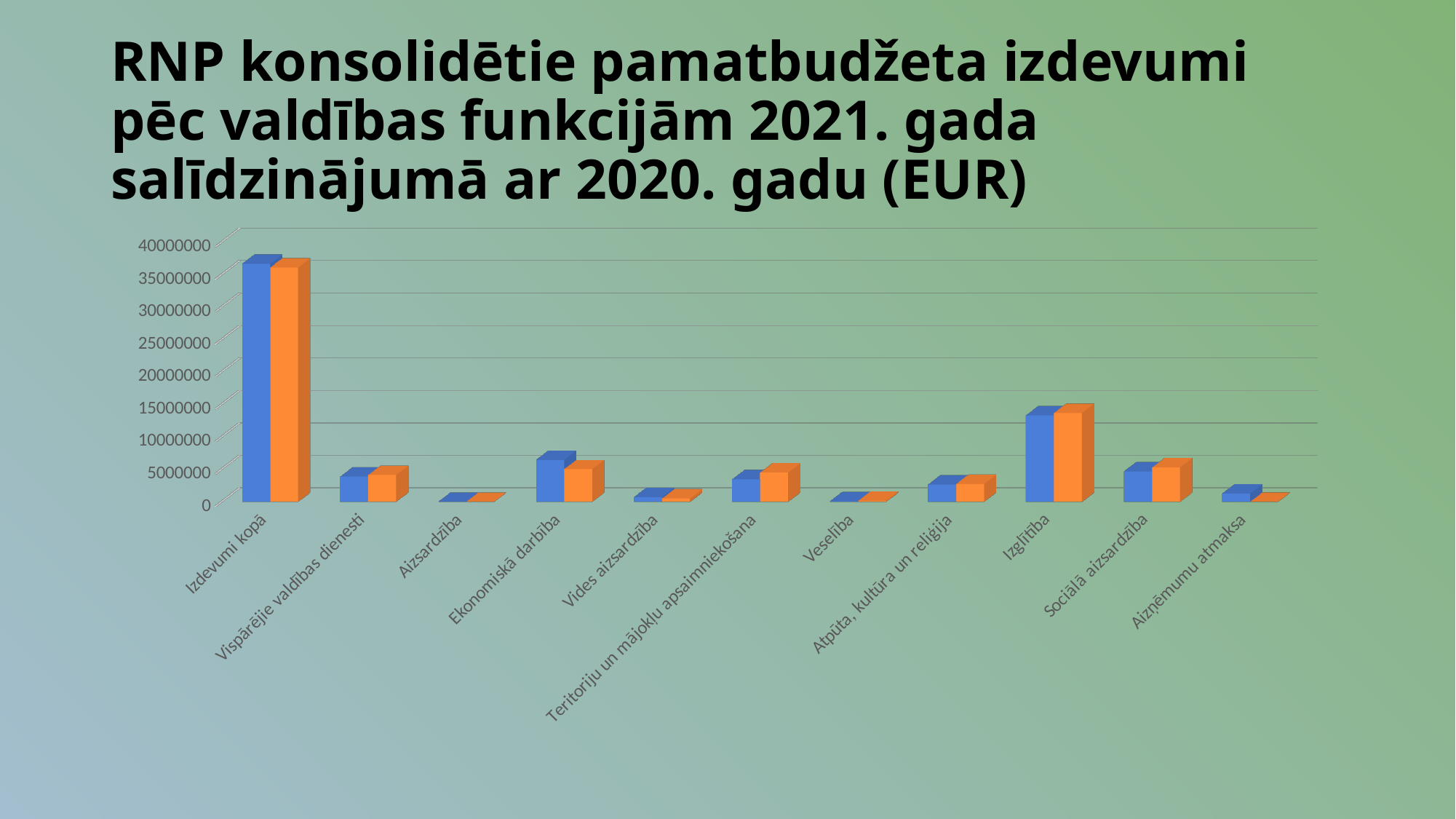
What kind of chart is shown on the slide? bar chart Which category has the highest bars in the chart? Izdevumi kopā What is the title of the chart slide? RNP konsolidētie pamatbudžeta izdevumi pēc valdības funkcijām 2021. gada salīdzinājumā ar 2020. gadu (EUR) For Aizņēmumu atmaksa, which bar is larger, the blue one or the orange one? the blue one How many categories are shown on the x axis of the chart? 11 Is the blue bar for Izglītība greater or less than 10000000? greater Is the orange bar for Izglītība greater or less than 15000000? less Is the blue bar for Vispārējie valdības dienesti greater or less than 5000000? less Which has the larger blue bar, Ekonomiskā darbība or Vispārējie valdības dienesti? Ekonomiskā darbība Apart from Izdevumi kopā, which category has the highest bars? Izglītība